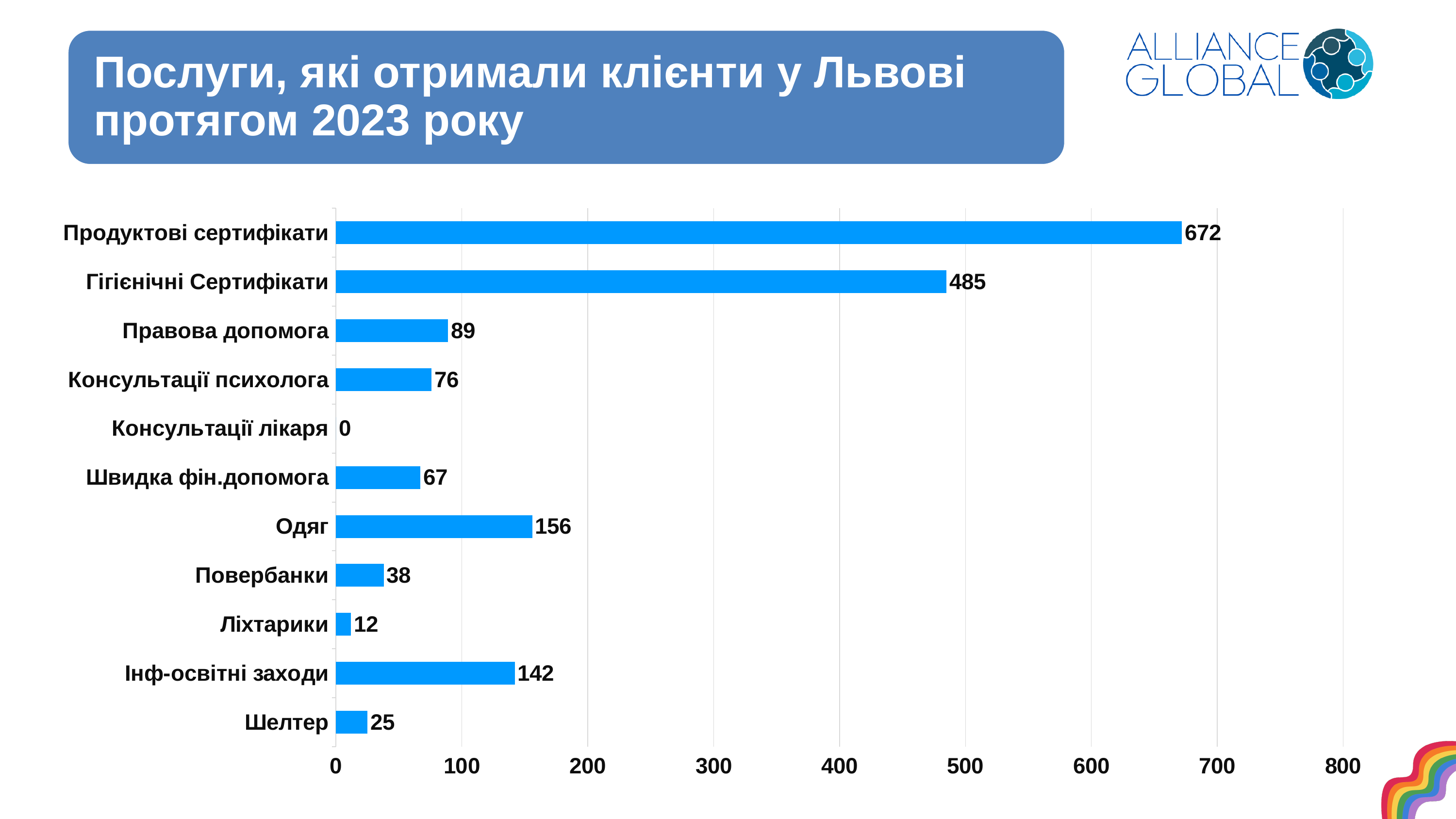
What is the difference between Продуктові сертифікати and Гігієнічні Сертифікати? 187 What is the value for Гігієнічні Сертифікати? 485 Which category has the highest value? Продуктові сертифікати Which is larger, Одяг or Інф-освітні заходи? Одяг What is the title of the slide? Послуги, які отримали клієнти у Львові протягом 2023 року What kind of chart is shown on the slide? bar chart What is the value for Одяг? 156 Which category has the lowest value? Консультації лікаря What is the value for Консультації лікаря? 0 What is the value for Продуктові сертифікати? 672 Is the value for Правова допомога greater or less than 100? less How many categories are shown in the chart? 11